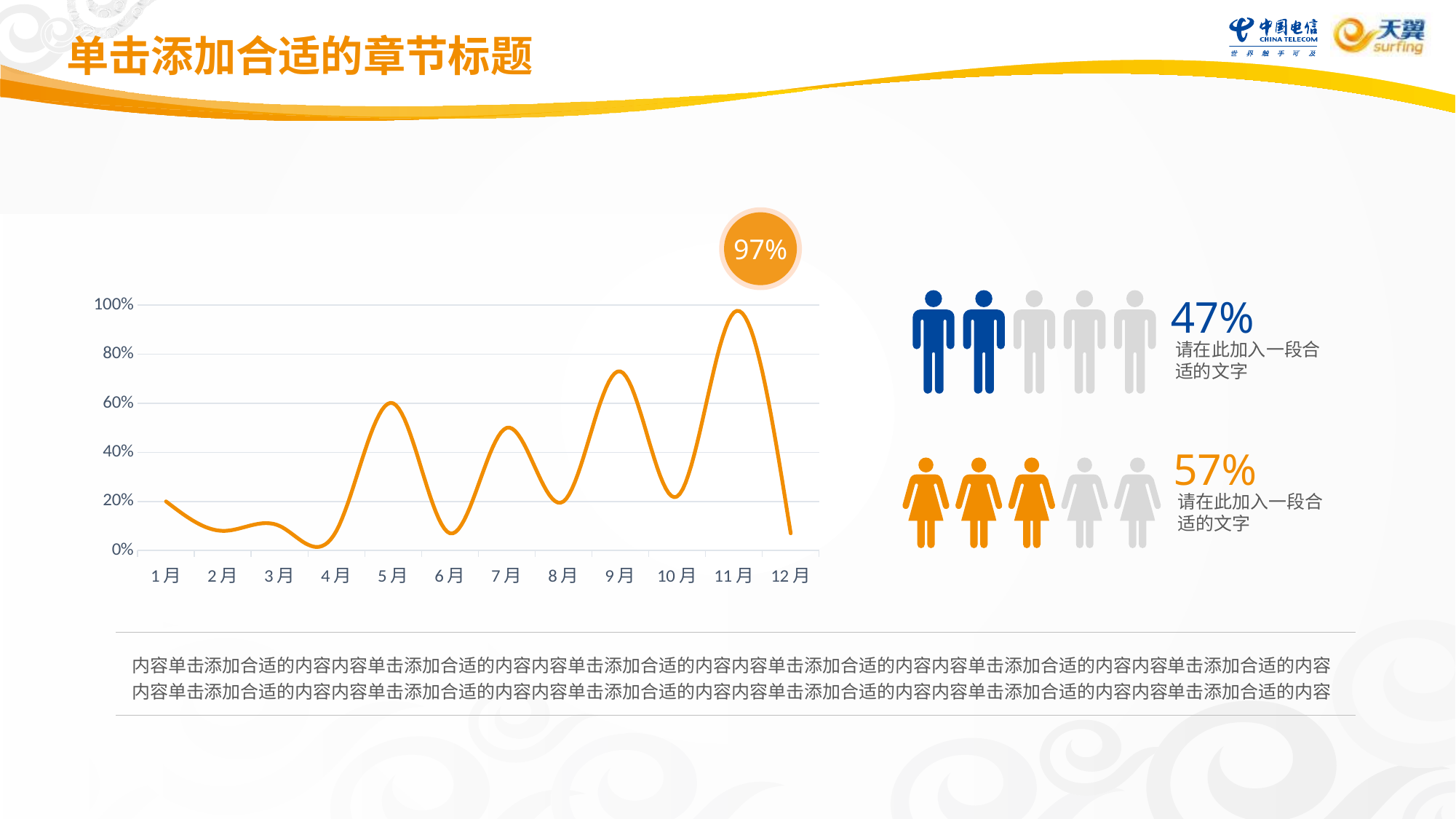
Which is larger, the value for 5月 or the value for 7月? 5月 Is the value for 12月 greater or less than 20%? less Does the line rise or fall from 11月 to 12月? fall What kind of chart is shown on the left of the slide? line chart How many months are shown on the x axis of the line chart? 12 Is the value for 10月 greater or less than 40%? less Is the value for 7月 greater or less than 40%? greater What is the highest tick shown on the y axis of the line chart? 100% Which month has the highest value in the line chart? 11月 What value is shown in the callout above the peak at 11月? 97%